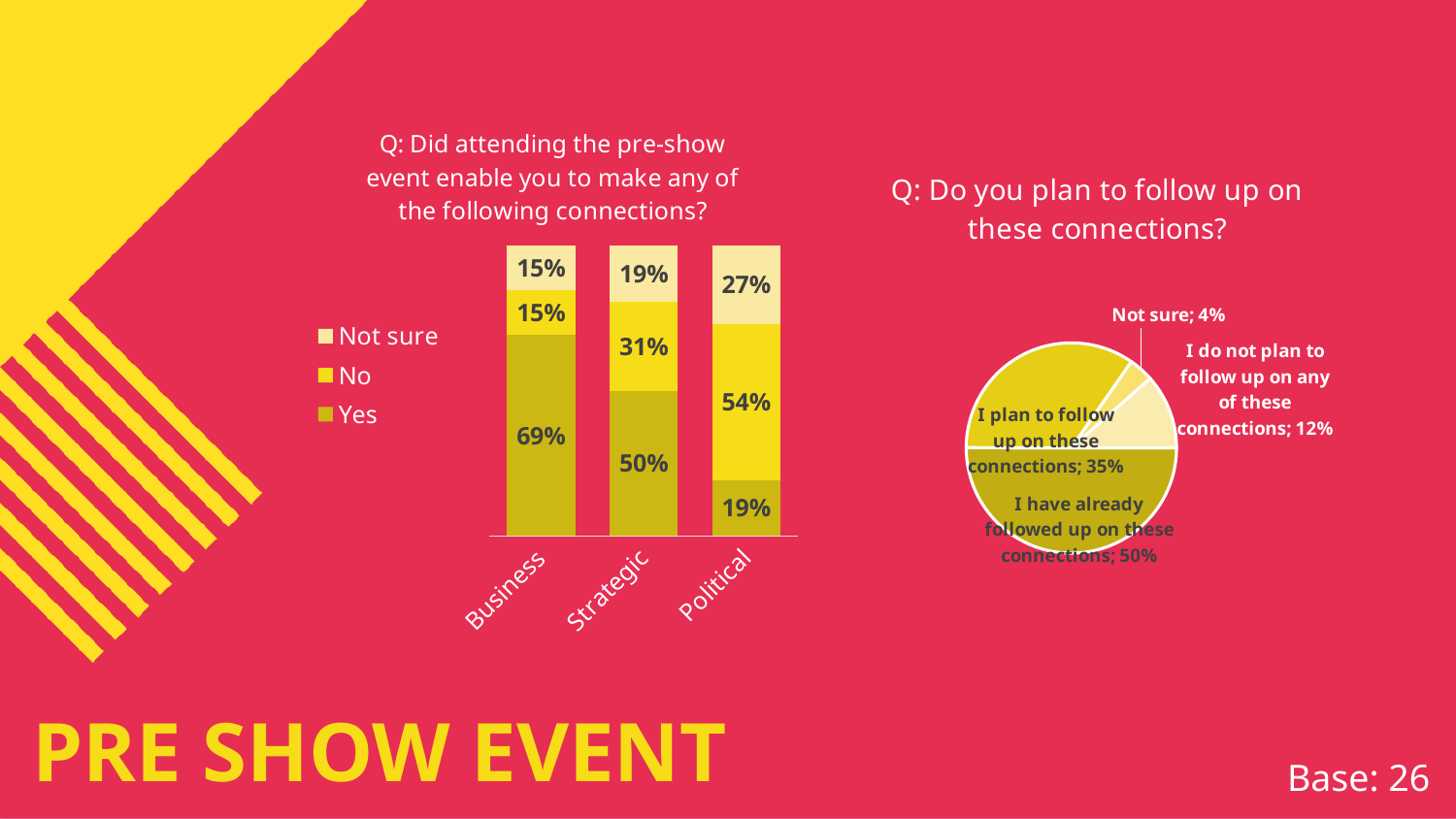
In the stacked bar chart on the left, is the No percentage larger for Strategic or for Political? Political In the pie chart on the right, what share of respondents said they have already followed up on these connections? 50% What type of chart is used for the question about making connections on the left? Bar chart In the stacked bar chart on the left, what percentage answered Yes for Business connections? 69% In the stacked bar chart on the left, what percentage answered No for Political connections? 54% In the stacked bar chart on the left, which category has the lowest Yes percentage? Political In the pie chart on the right, what is the difference between the share who plan to follow up and the share who do not plan to follow up? 23% In the pie chart on the right, which response has the smallest share? Not sure In the stacked bar chart on the left, what percentage answered Not sure for Strategic connections? 19% In the stacked bar chart on the left, which category has the highest Yes percentage? Business In the stacked bar chart on the left, what is the difference between the Yes percentages for Business and Strategic? 19% How many series does the legend of the stacked bar chart on the left list? 3